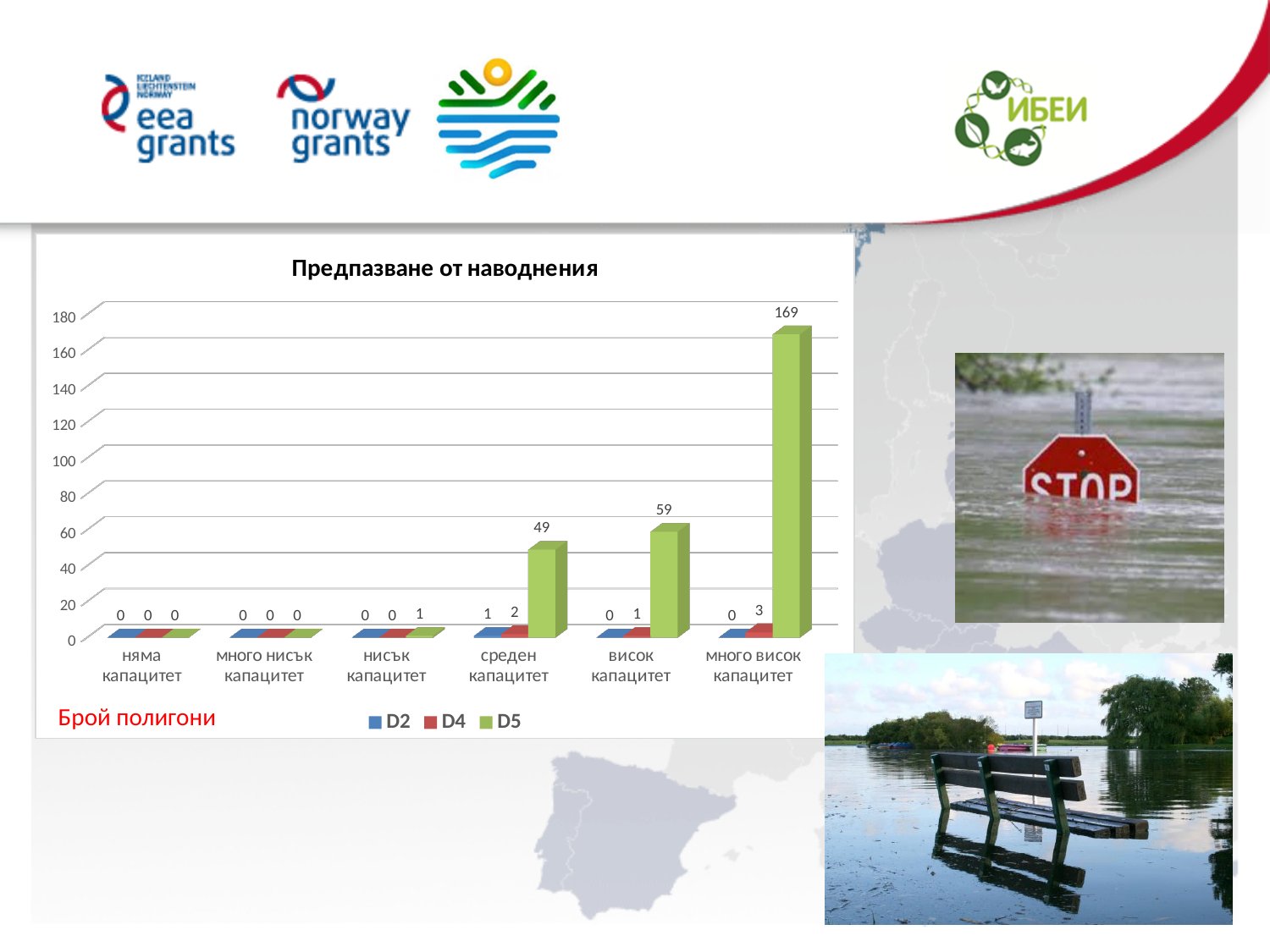
What is the total of the D2, D4 and D5 values for "среден капацитет"? 52 Which category has the highest D5 value? много висок капацитет What is the title of the chart? Предпазване от наводнения What is the value of D5 for "среден капацитет"? 49 What is the difference between the D5 values for "много висок капацитет" and "висок капацитет"? 110 Which is larger: the D5 value for "висок капацитет" or for "среден капацитет"? висок капацитет How many series does the chart legend list? 3 What is the value of D5 for "много висок капацитет"? 169 Do the D5 values rise or fall moving from left to right along the x axis? rise What type of chart is shown on the slide? bar chart How many categories are shown on the x axis of the chart? 6 What is the value of D4 for "много висок капацитет"? 3